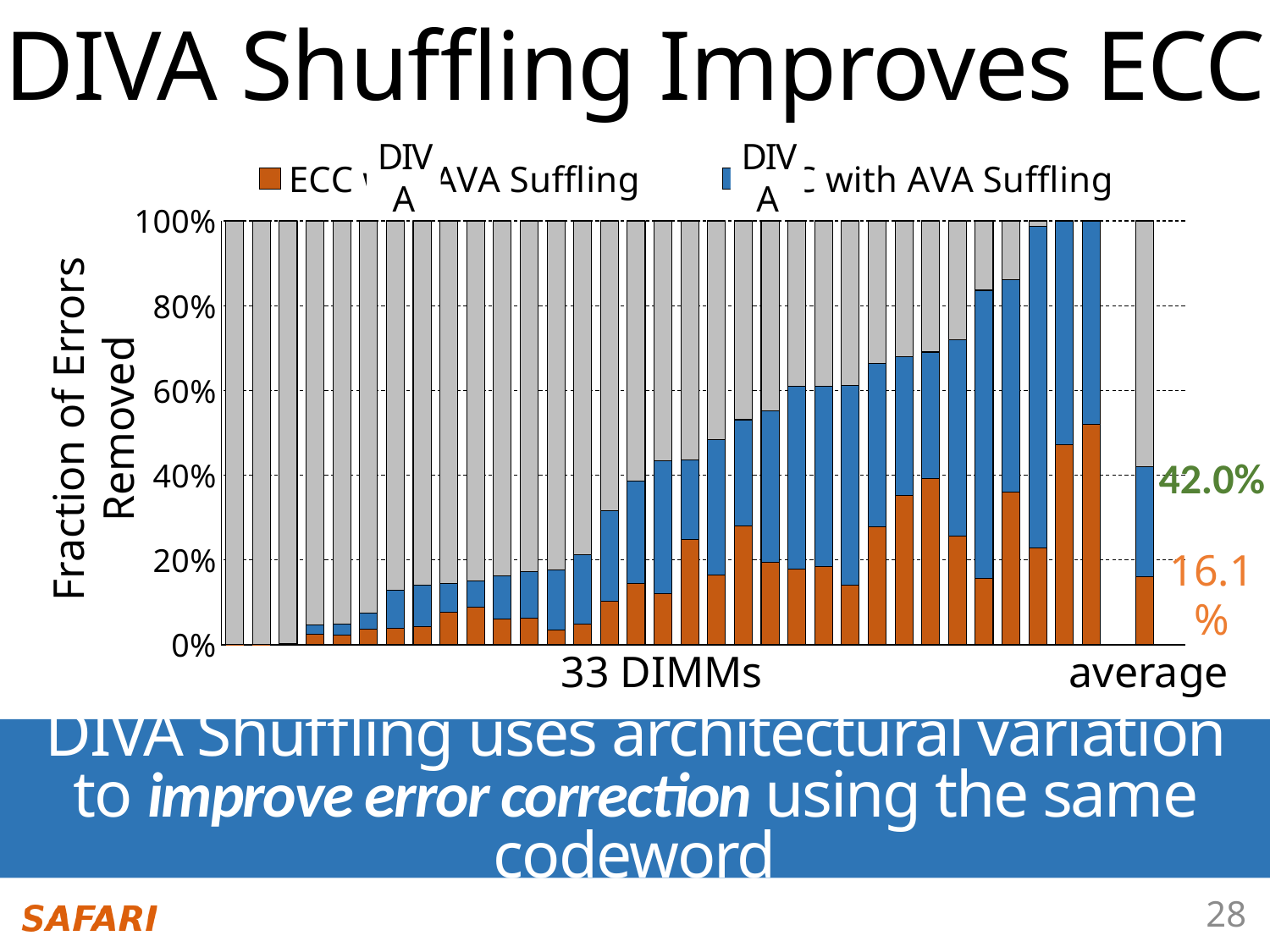
Which colour represents ECC with DIVA Shuffling in the chart? Blue Is the average fraction of errors removed with DIVA Shuffling greater or less than 40%? greater Is the fraction of errors removed with DIVA Shuffling for the leftmost DIMM greater or less than 20%? less What kind of chart is shown on the slide? Stacked bar chart What is the average fraction of errors removed by ECC with DIVA Shuffling? 42.0% By how many percentage points does the average for ECC with DIVA Shuffling exceed the average for ECC without DIVA Shuffling? 25.9 percentage points How many series does the legend list? 2 How many DIMMs are plotted in the chart (excluding the average bar)? 33 What is the label of the y axis? Fraction of Errors Removed What is the average fraction of errors removed by ECC without DIVA Shuffling? 16.1% Do the fractions of errors removed rise or fall moving left to right across the DIMMs? Rise For the average bar, which is larger: the fraction of errors removed with DIVA Shuffling or without DIVA Shuffling? With DIVA Shuffling